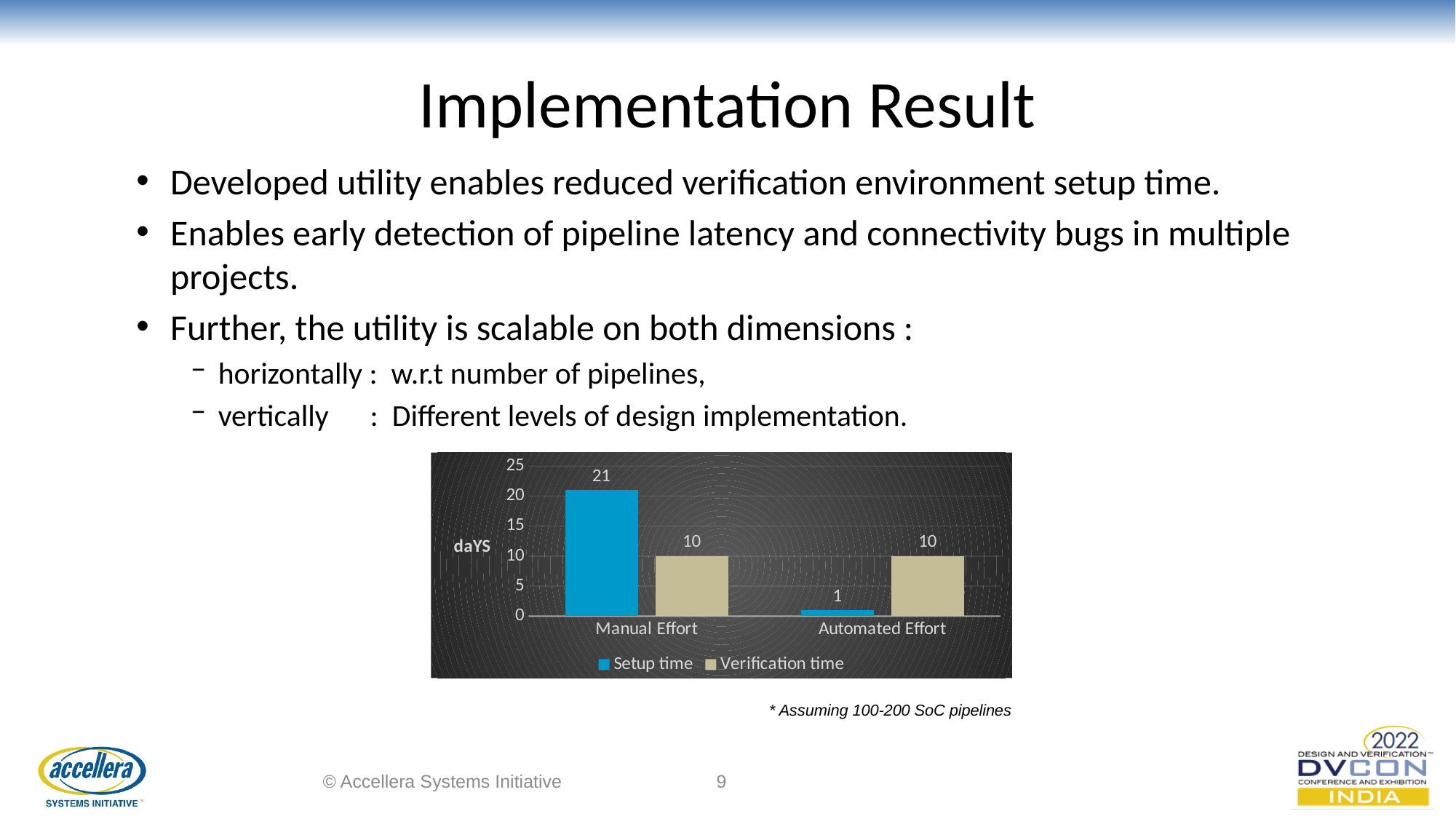
How many series does the chart legend list? 2 Which category has the lowest Setup time? Automated Effort What is the Verification time value for Manual Effort? 10 What kind of chart is shown on the slide? Bar chart What is the Setup time value for Automated Effort? 1 For Manual Effort, which is larger: Setup time or Verification time? Setup time What is the Verification time value for Automated Effort? 10 What is the label on the vertical axis of the chart? daYS Which category has the highest Setup time? Manual Effort How many categories are shown on the x axis of the chart? 2 What is the difference in Setup time between Manual Effort and Automated Effort? 20 What is the Setup time value for Manual Effort? 21